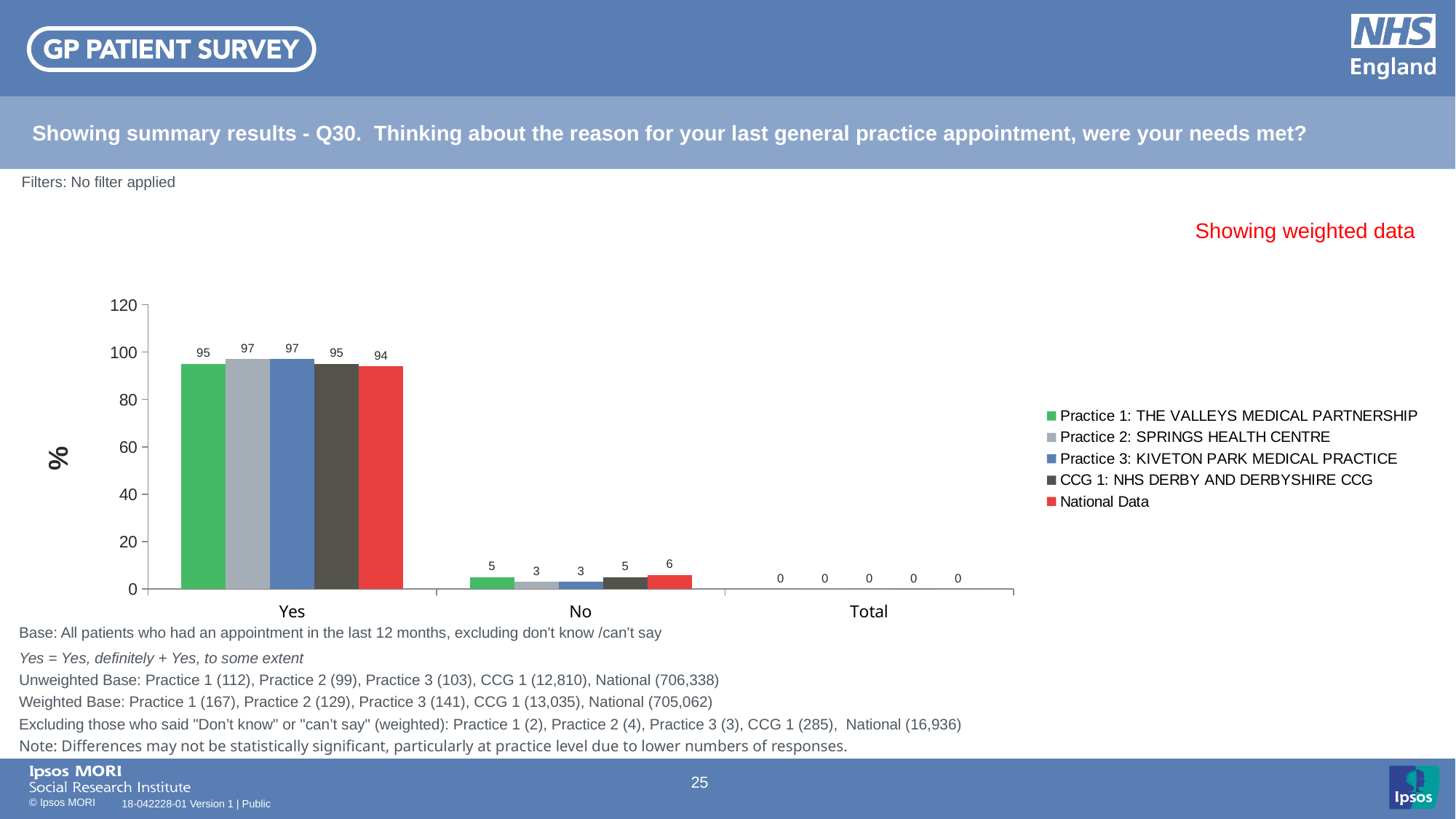
Which series has the lowest value in the Yes category? National Data What is the value for CCG 1: NHS DERBY AND DERBYSHIRE CCG in the No category? 5 How many categories are shown on the x axis? 3 How many series does the legend list? 5 Which series has the highest value in the No category? National Data What is the difference between the Yes values for Practice 3: KIVETON PARK MEDICAL PRACTICE and National Data? 3 What is the value for Practice 1: THE VALLEYS MEDICAL PARTNERSHIP in the Yes category? 95 Which is larger: the No value for Practice 1: THE VALLEYS MEDICAL PARTNERSHIP or for Practice 2: SPRINGS HEALTH CENTRE? Practice 1: THE VALLEYS MEDICAL PARTNERSHIP What is the value for Practice 2: SPRINGS HEALTH CENTRE in the Yes category? 97 What kind of chart is shown on the slide? Bar chart What colour represents National Data in the chart? Red What is the value for National Data in the No category? 6